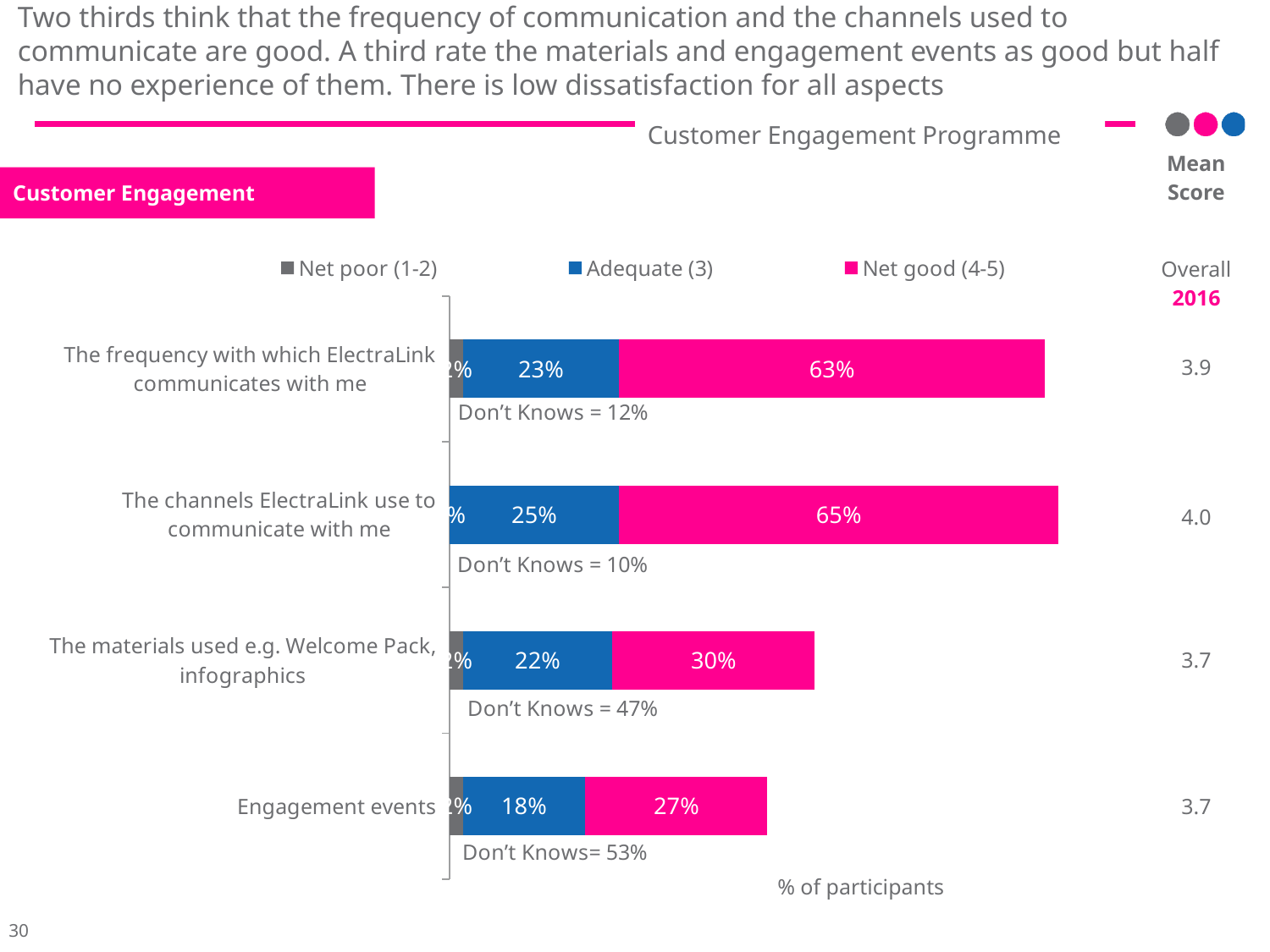
What is the Net good (4-5) value for 'The frequency with which ElectraLink communicates with me'? 63% How many series does the chart legend list? 3 What is the Adequate (3) value for 'The channels ElectraLink use to communicate with me'? 25% Which category has the highest Net good (4-5) value? The channels ElectraLink use to communicate with me What is the difference between the Net good (4-5) values for 'The channels ElectraLink use to communicate with me' and 'Engagement events'? 38% How many categories are plotted in the chart? 4 Which legend entry is shown in pink? Net good (4-5) What is the Adequate (3) value for 'Engagement events'? 18% What is the Net good (4-5) value for 'The materials used e.g. Welcome Pack, infographics'? 30% Which is larger: the Adequate (3) value for 'The frequency with which ElectraLink communicates with me' or for 'The materials used e.g. Welcome Pack, infographics'? The frequency with which ElectraLink communicates with me What kind of chart is shown on the slide? Stacked bar chart Which category has the lowest Net good (4-5) value? Engagement events